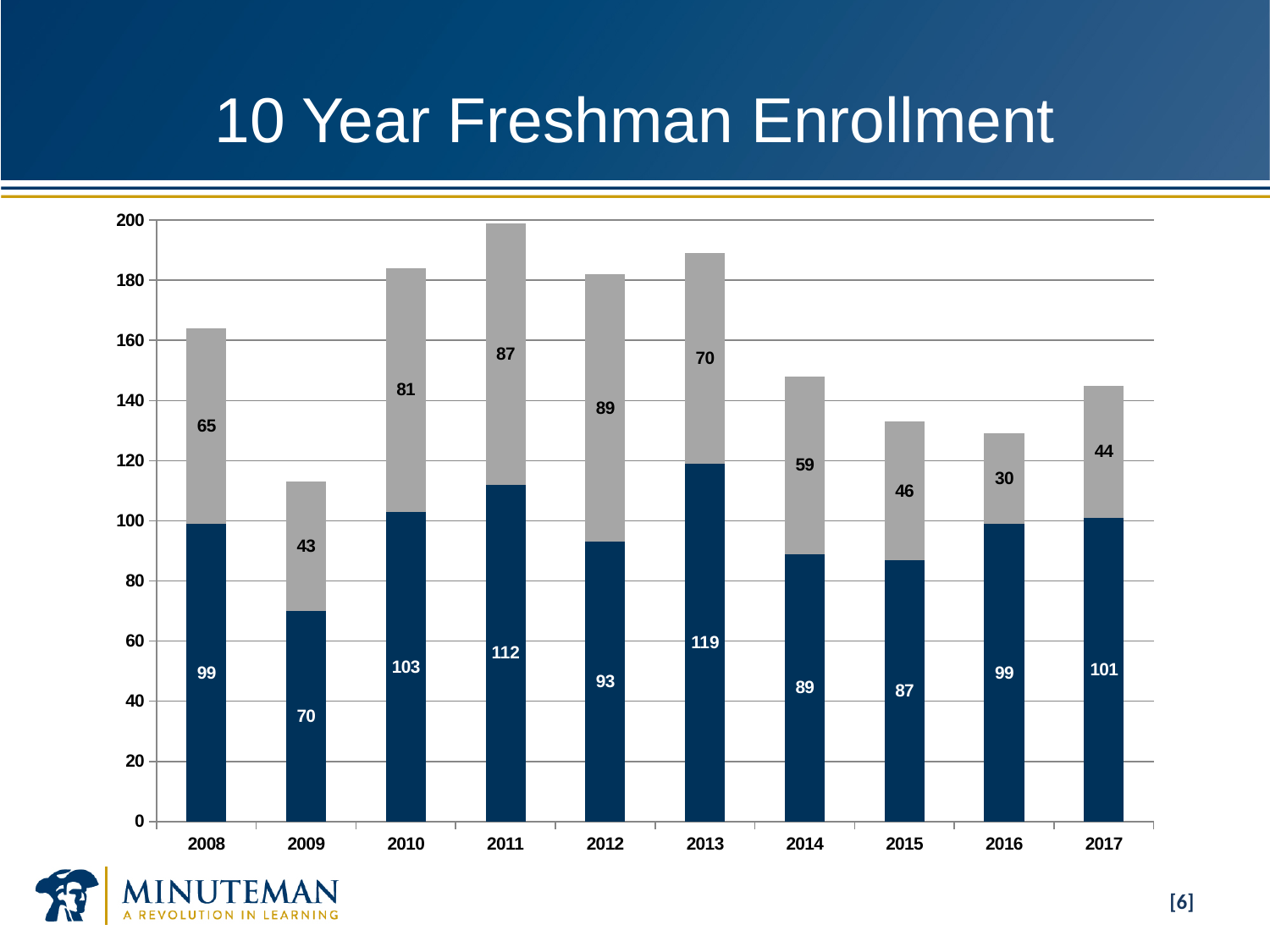
What is the difference between the dark blue segment values for 2011 and 2009? 42 What is the total of the stacked bar for 2008? 164 Which year has the lowest gray segment value? 2016 What is the title of the slide? 10 Year Freshman Enrollment How many years are shown on the x axis? 10 Which year has the highest dark blue segment value? 2013 What is the total of the stacked bar for 2011? 199 What is the value of the dark blue segment for 2013? 119 What is the value of the gray segment for 2016? 30 Is the total bar height for 2015 greater or less than 140? less What kind of chart is shown on the slide? Stacked bar chart Which is larger, the gray segment for 2012 or the gray segment for 2014? 2012